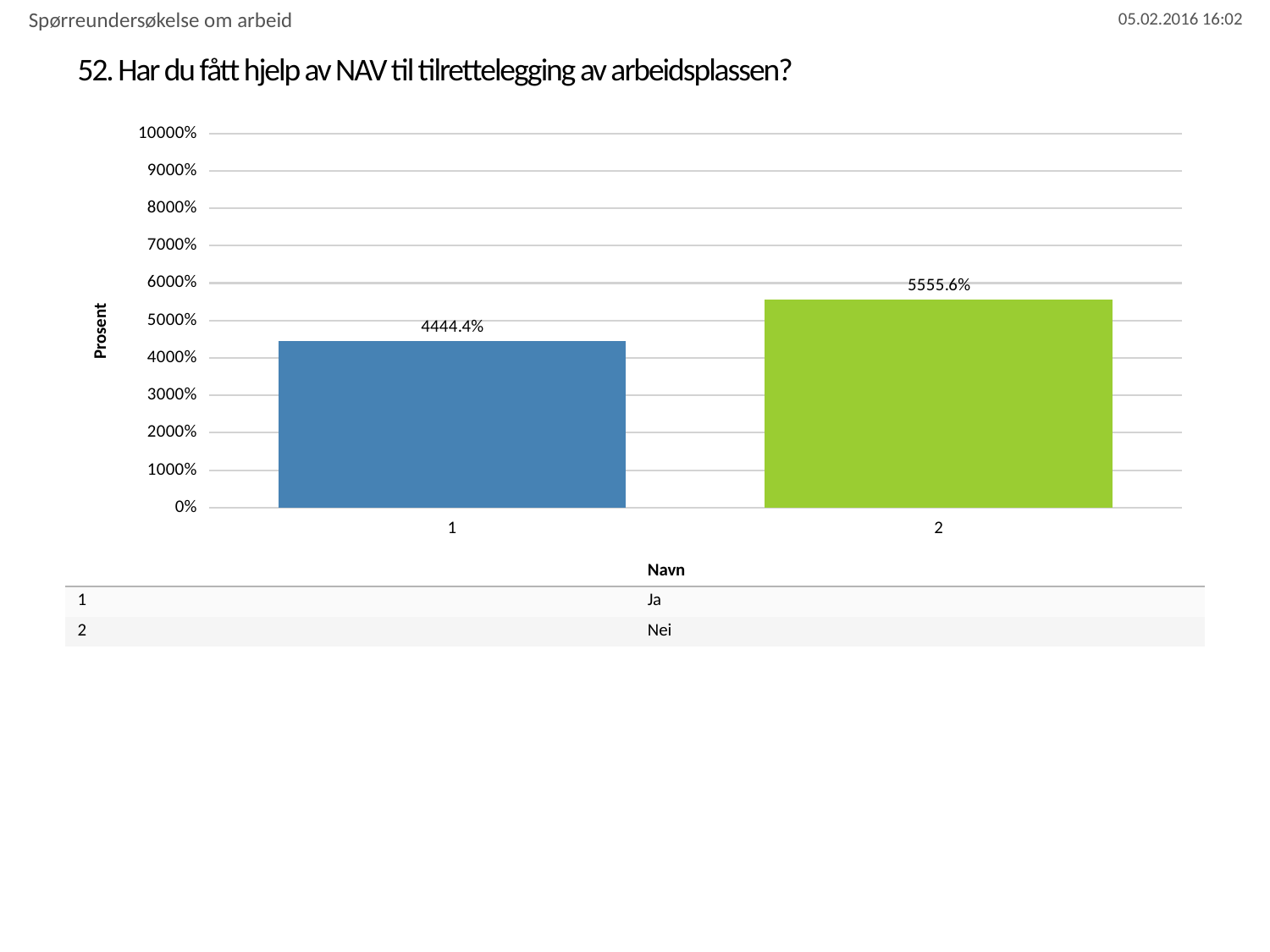
What is the value shown for category 2? 5555.6% Which category has the highest value? 2 Is the value for category 2 greater or less than 5000%? greater What is the label of the vertical axis? Prosent What is the difference between the values for category 2 and category 1? 1111.2% According to the table below the chart, what name corresponds to category 2? Nei Which is larger, the value for category 1 or category 2? 2 Which category has the lowest value? 1 What is the value shown for category 1? 4444.4% What kind of chart is shown on the slide? bar chart Is the value for category 1 greater or less than 5000%? less How many bars are plotted in the chart? 2